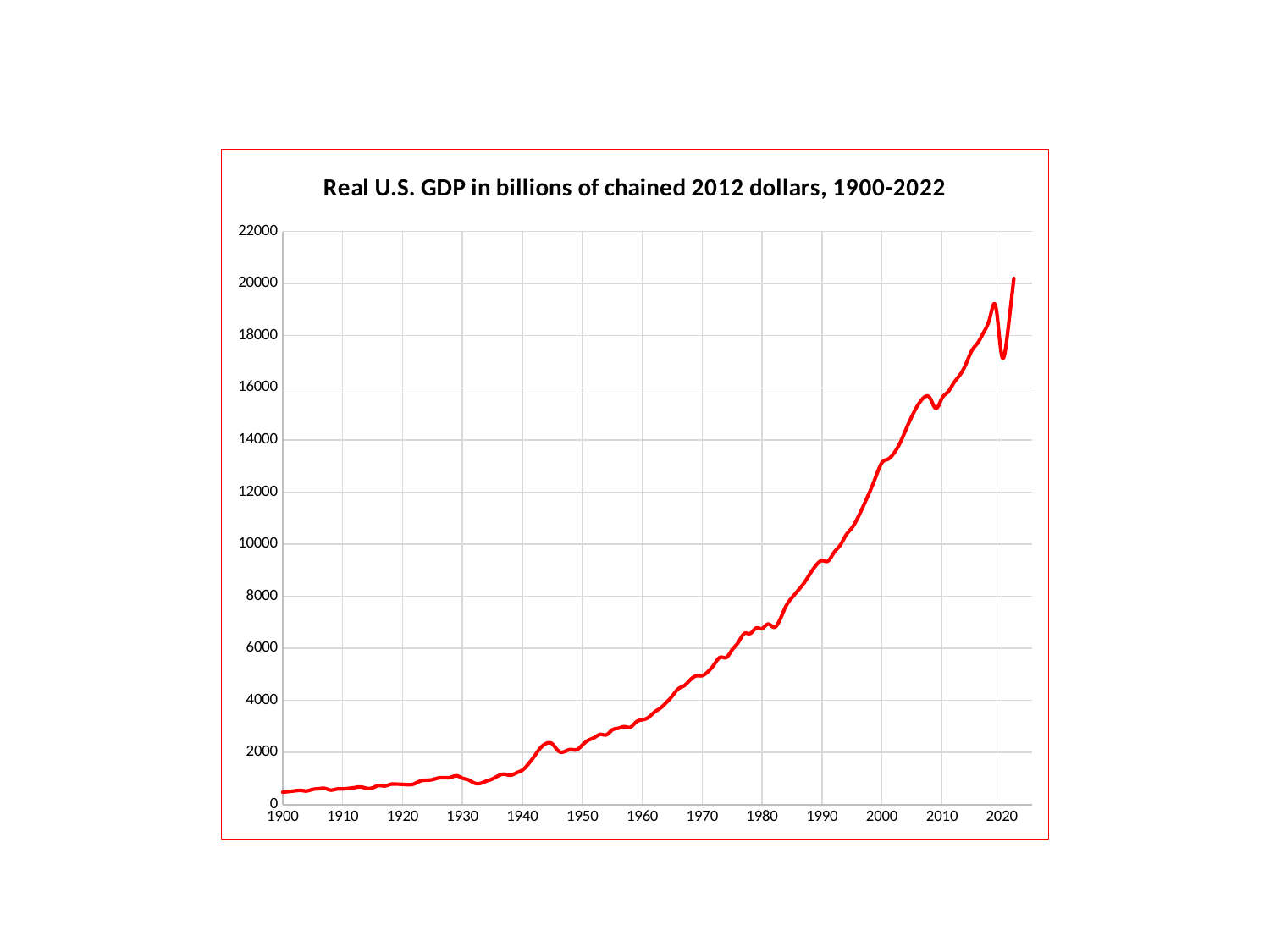
Is the value for 1950 greater or less than 4000? less Do the values generally rise or fall from 1900 to 2022? rise What is the title of the chart? Real U.S. GDP in billions of chained 2012 dollars, 1900-2022 What kind of chart is shown on the slide? line chart What colour is the line on the chart? red Which year has the highest value on the chart? 2022 Is the value for 1990 greater or less than 10000? less Is the value for 1940 greater or less than 2000? less Which is larger, the value for 2019 or the value for 2020? 2019